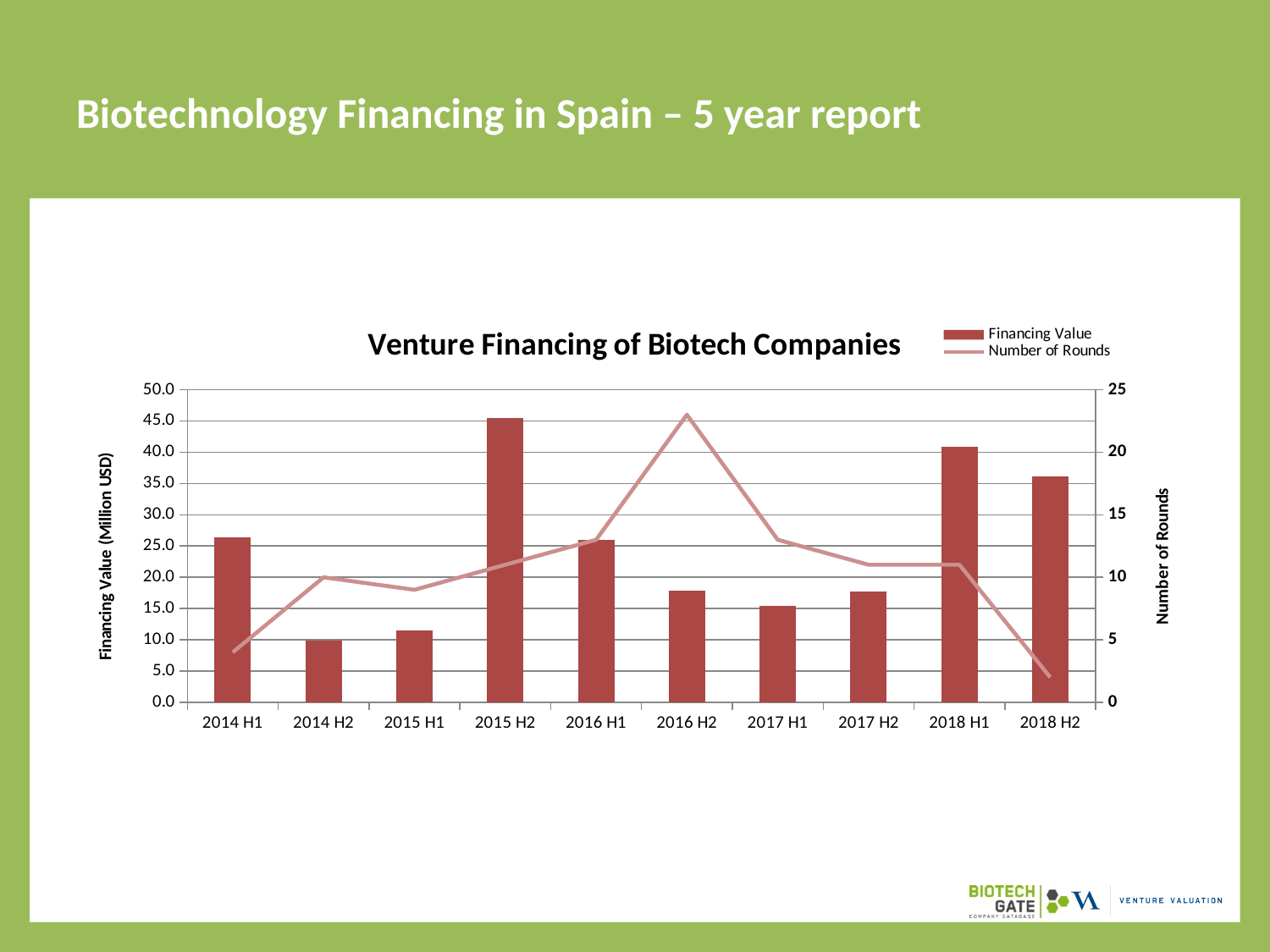
How many time periods are shown on the x axis? 10 What is the title of the chart? Venture Financing of Biotech Companies Is the Number of Rounds for 2016 H2 greater or less than 20? greater Which period has the lowest Number of Rounds? 2018 H2 What is the label of the right-hand vertical axis? Number of Rounds Which period has the highest Number of Rounds? 2016 H2 Which has the larger Financing Value, 2018 H1 or 2018 H2? 2018 H1 Is the Financing Value for 2015 H2 greater or less than 40.0? greater Which period has the highest Financing Value? 2015 H2 Is the Financing Value for 2017 H1 greater or less than 20.0? less How many series does the legend list? 2 Which period has the lowest Financing Value? 2014 H2